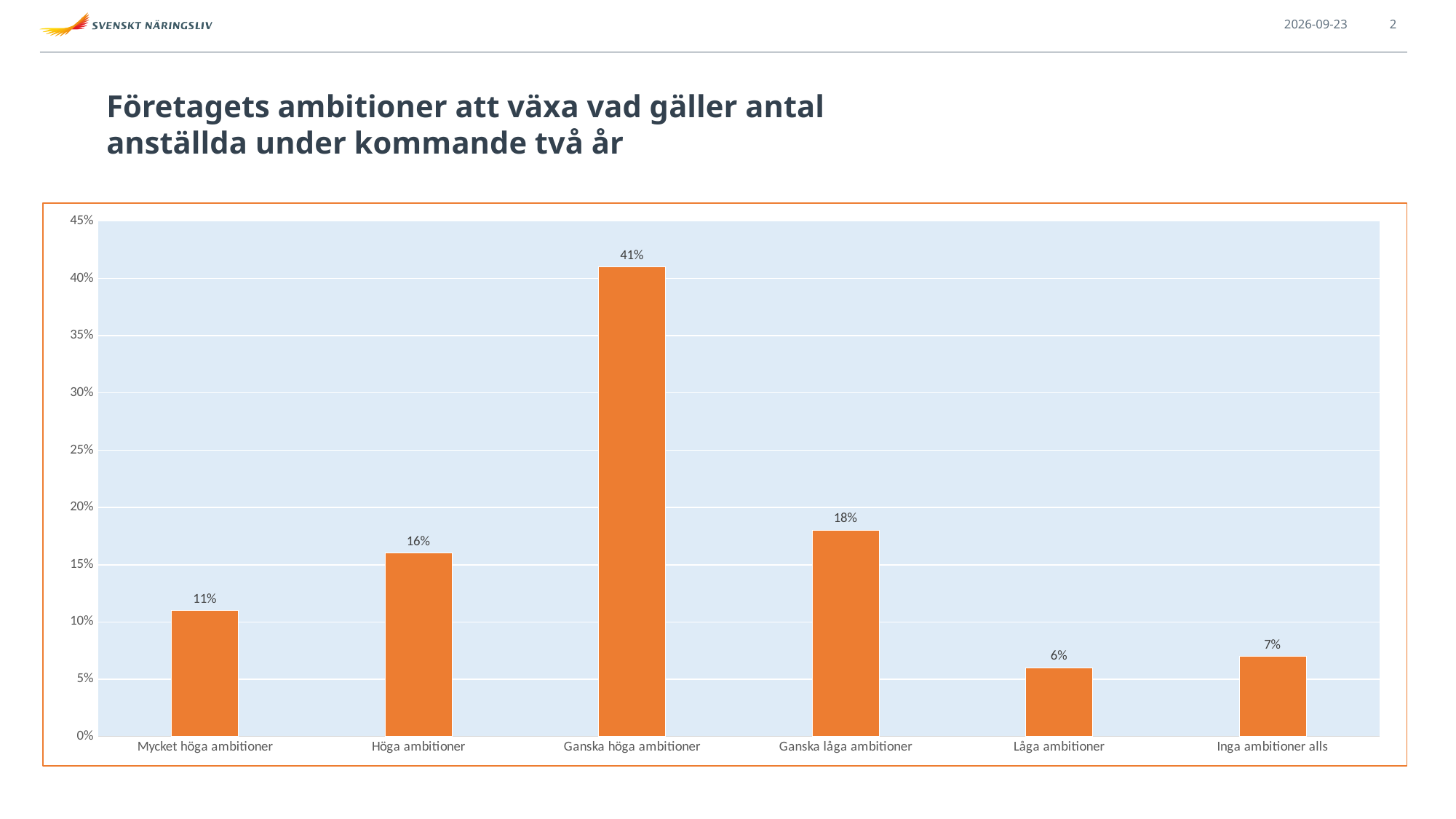
Which category has the lowest value? Låga ambitioner What is the value for Inga ambitioner alls? 7% What is the difference between Ganska höga ambitioner and Ganska låga ambitioner? 23 percentage points Which is larger, Höga ambitioner or Ganska låga ambitioner? Ganska låga ambitioner Is the value for Ganska höga ambitioner greater or less than 40%? greater What kind of chart is shown on the slide? Bar chart What is the title of the slide? Företagets ambitioner att växa vad gäller antal anställda under kommande två år What is the value for Mycket höga ambitioner? 11% What is the value for Ganska höga ambitioner? 41% What is the difference between Höga ambitioner and Mycket höga ambitioner? 5 percentage points How many categories are shown on the x axis? 6 Which category has the highest value? Ganska höga ambitioner